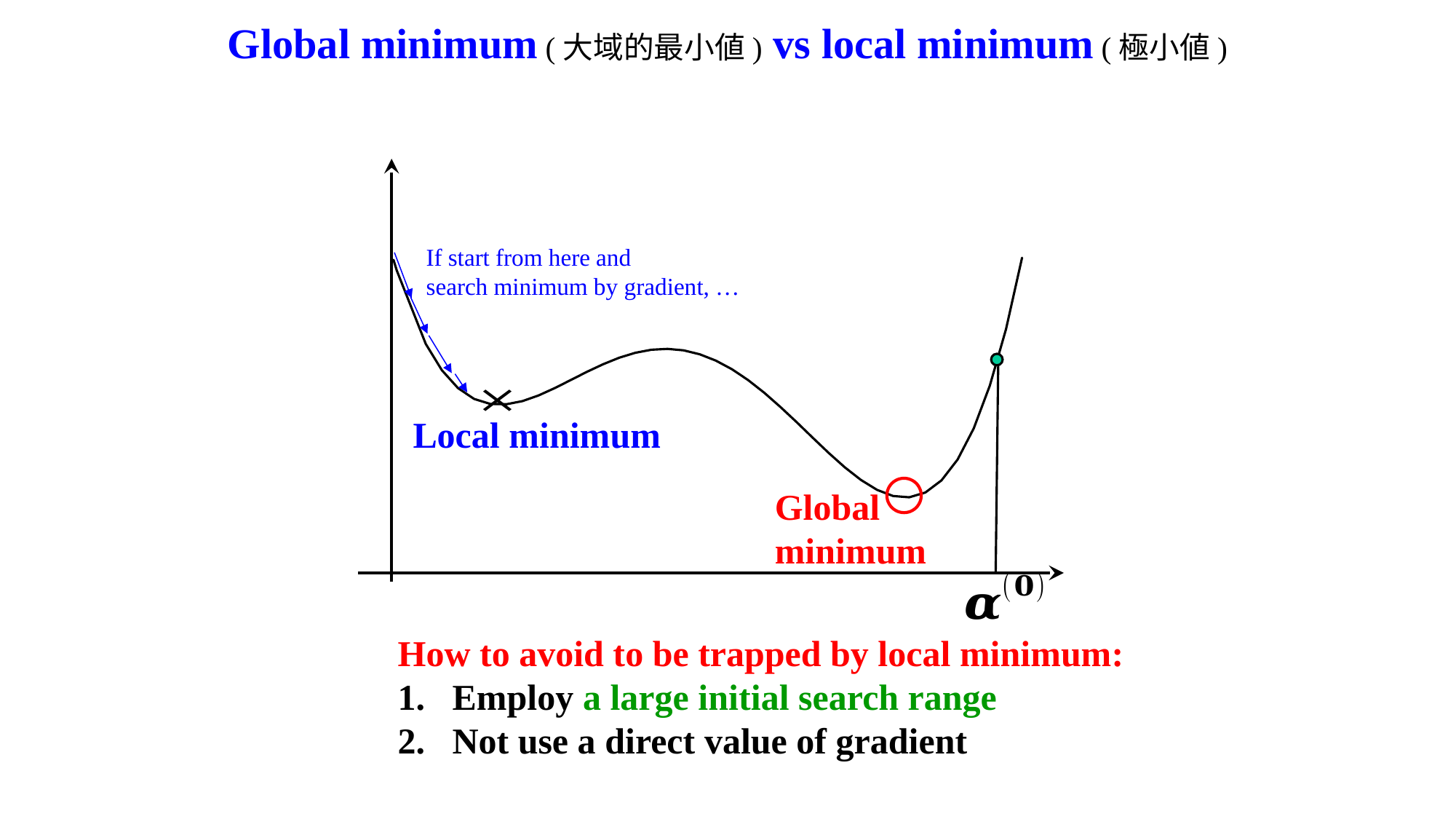
What label is written at the right end of the x axis? α^(0) How many minima are labeled on the curve? 2 What colour is the circle marking the global minimum? Red What kind of chart is shown on the slide? Line chart After the global minimum, does the curve rise or fall toward the right end? Rise Starting from the left end of the curve, does the curve rise or fall toward the local minimum? Fall Which point on the curve is lower, the local minimum or the global minimum? Global minimum